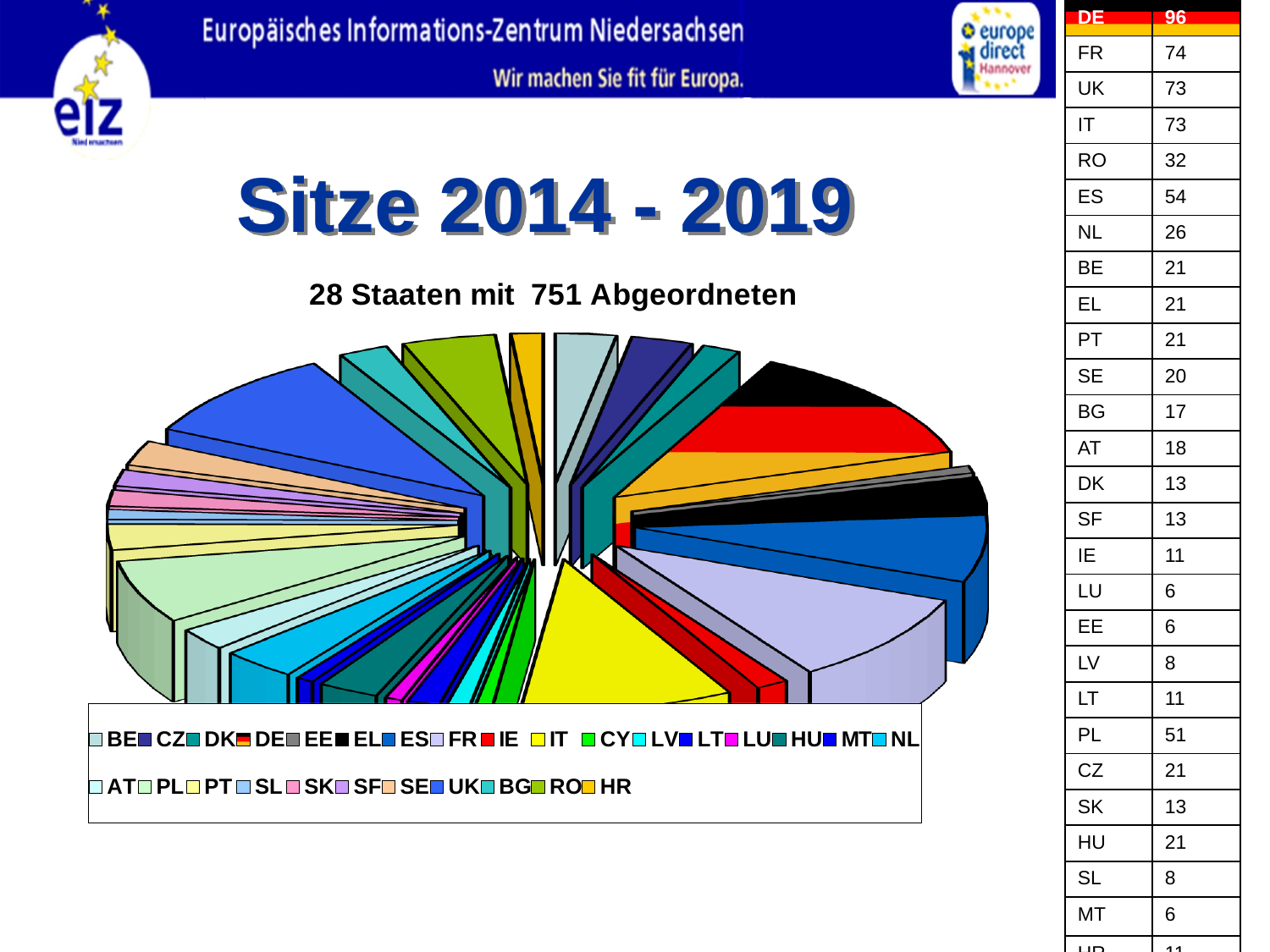
What is the title of the slide's chart? 28 Staaten mit 751 Abgeordneten Which has more seats, ES or NL? ES What kind of chart is shown on the slide? pie chart According to the table, how many seats does SE have? 20 What is the difference in seats between DE and FR? 22 What is the difference in seats between ES and PL? 3 How many countries (categories) does the pie chart's legend list? 28 According to the table, how many seats does PL have? 51 According to the table, how many seats does DE have? 96 According to the table, how many seats does FR have? 74 What is the total number of seats (Abgeordnete) stated on the slide? 751 Which country has the largest slice of the pie chart? DE